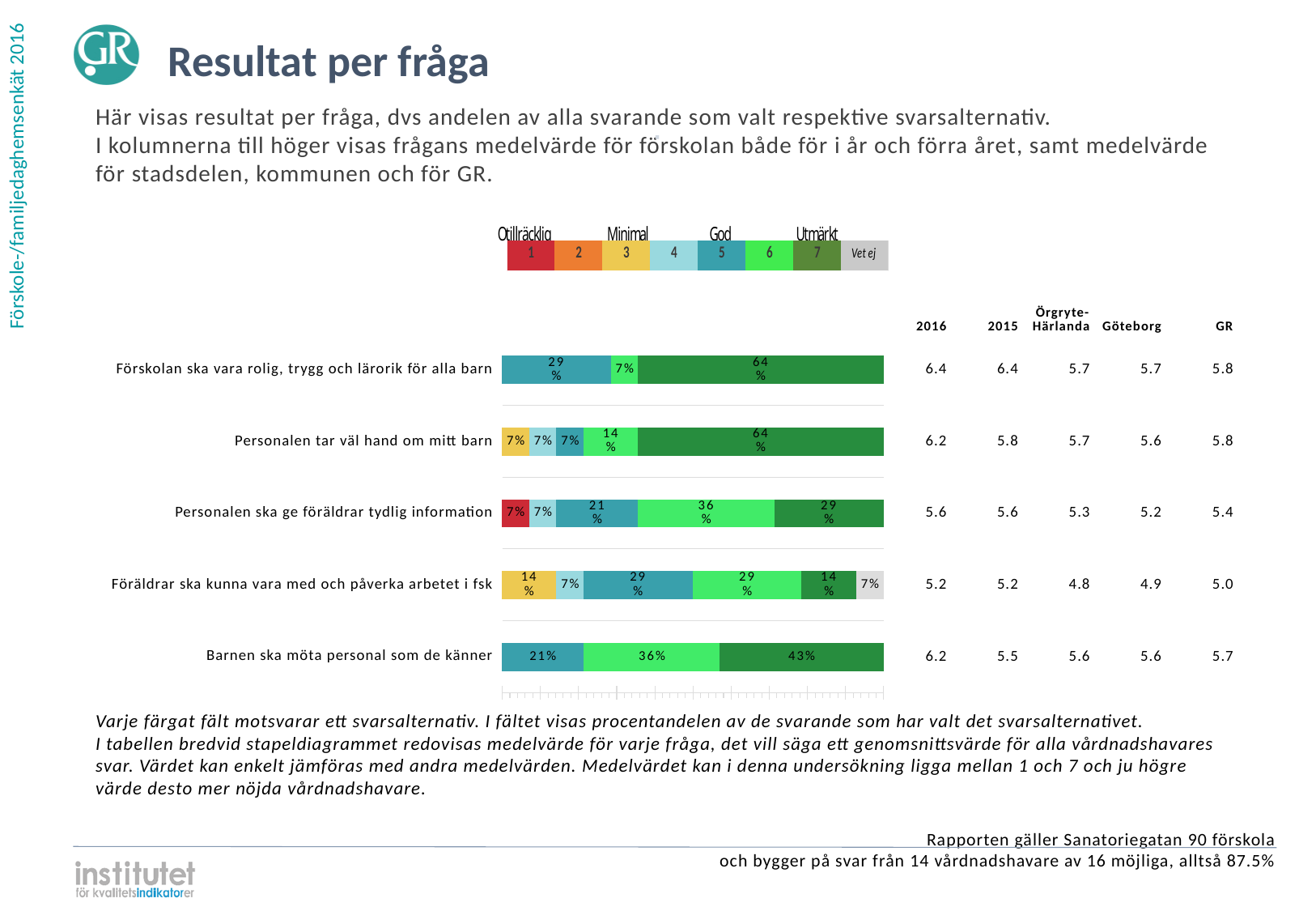
What percentage chose 'Vet ej' for 'Föräldrar ska kunna vara med och påverka arbetet i fsk'? 7% What percentage chose alternative 6 (light green) for 'Personalen ska ge föräldrar tydlig information'? 36% How many questions (categories) are plotted in the bar chart? 5 What is the difference in percentage points between the alternative 7 share (64%) and the alternative 5 share (29%) for 'Förskolan ska vara rolig, trygg och lärorik för alla barn'? 35 percentage points Which question has the smallest share of respondents choosing alternative 7 (dark green)? Föräldrar ska kunna vara med och påverka arbetet i fsk What percentage of respondents chose alternative 7 (dark green) for 'Förskolan ska vara rolig, trygg och lärorik för alla barn'? 64% Which is larger: the alternative 7 share for 'Barnen ska möta personal som de känner' or for 'Personalen ska ge föräldrar tydlig information'? Barnen ska möta personal som de känner What is the total of the segments in the bar for 'Barnen ska möta personal som de känner' (21%, 36%, 43%)? 100% What percentage chose alternative 7 (dark green) for 'Barnen ska möta personal som de känner'? 43% What is the 2016 mean value shown for 'Personalen tar väl hand om mitt barn'? 6.2 How many answer alternatives does the legend above the chart list? 8 What kind of chart is shown on the slide? Stacked bar chart